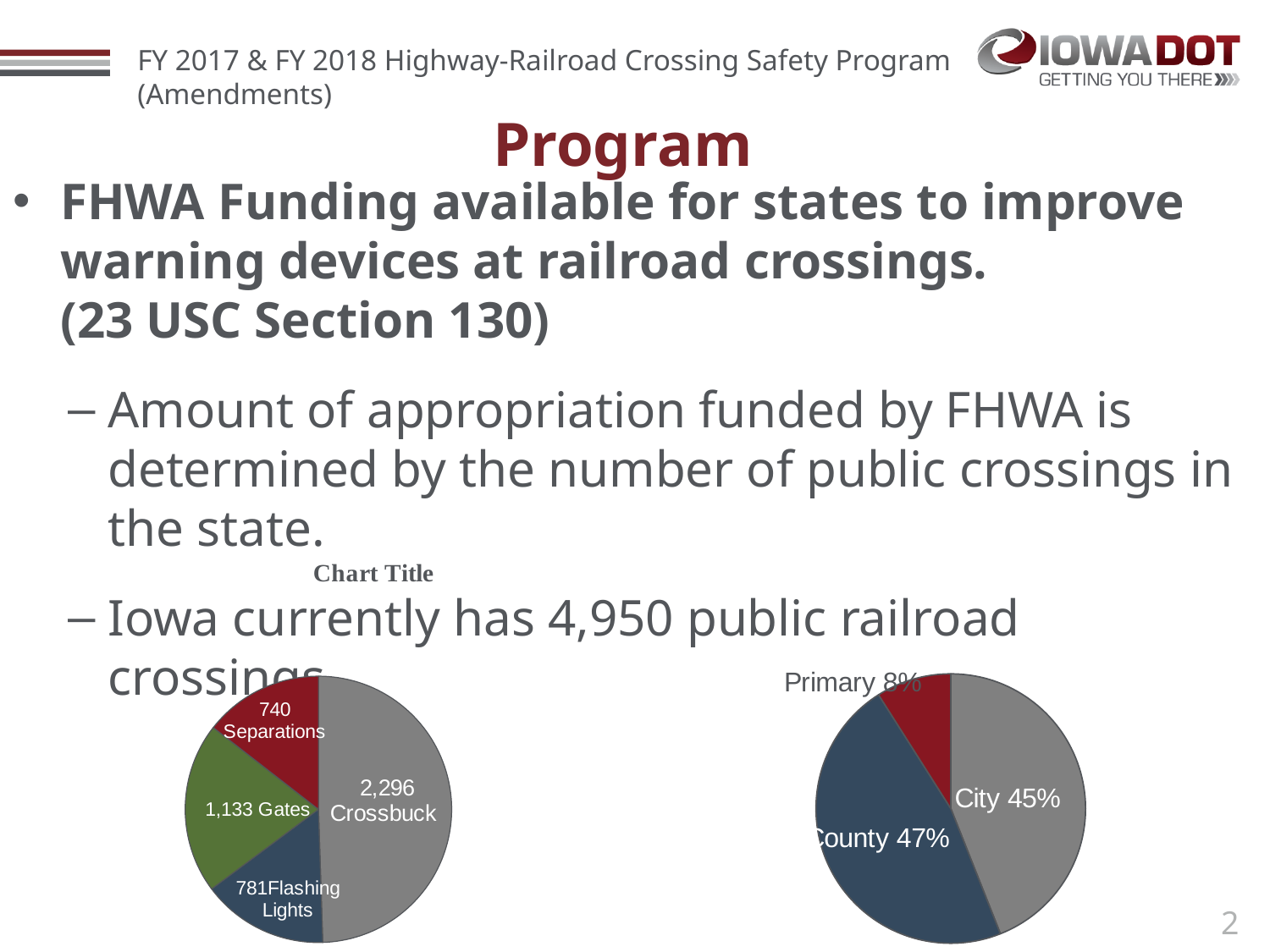
In the left pie chart, how many crossings are Crossbuck? 2,296 In the left pie chart, what is the value for Separations? 740 In the left pie chart, what is the difference between the Crossbuck and Gates values? 1,163 In the left pie chart, what is the value for Gates? 1,133 In the left pie chart, which category has the smallest value? Separations In the left pie chart, what is the total of all four slices? 4,950 What kind of chart is the right chart on the slide? Pie chart How many slices does the left pie chart have? 4 In the left pie chart, what is the value for Flashing Lights? 781 In the left pie chart, which category has the largest value? Crossbuck In the right pie chart, what share is County? 47% In the right pie chart, which is larger, City or County? County